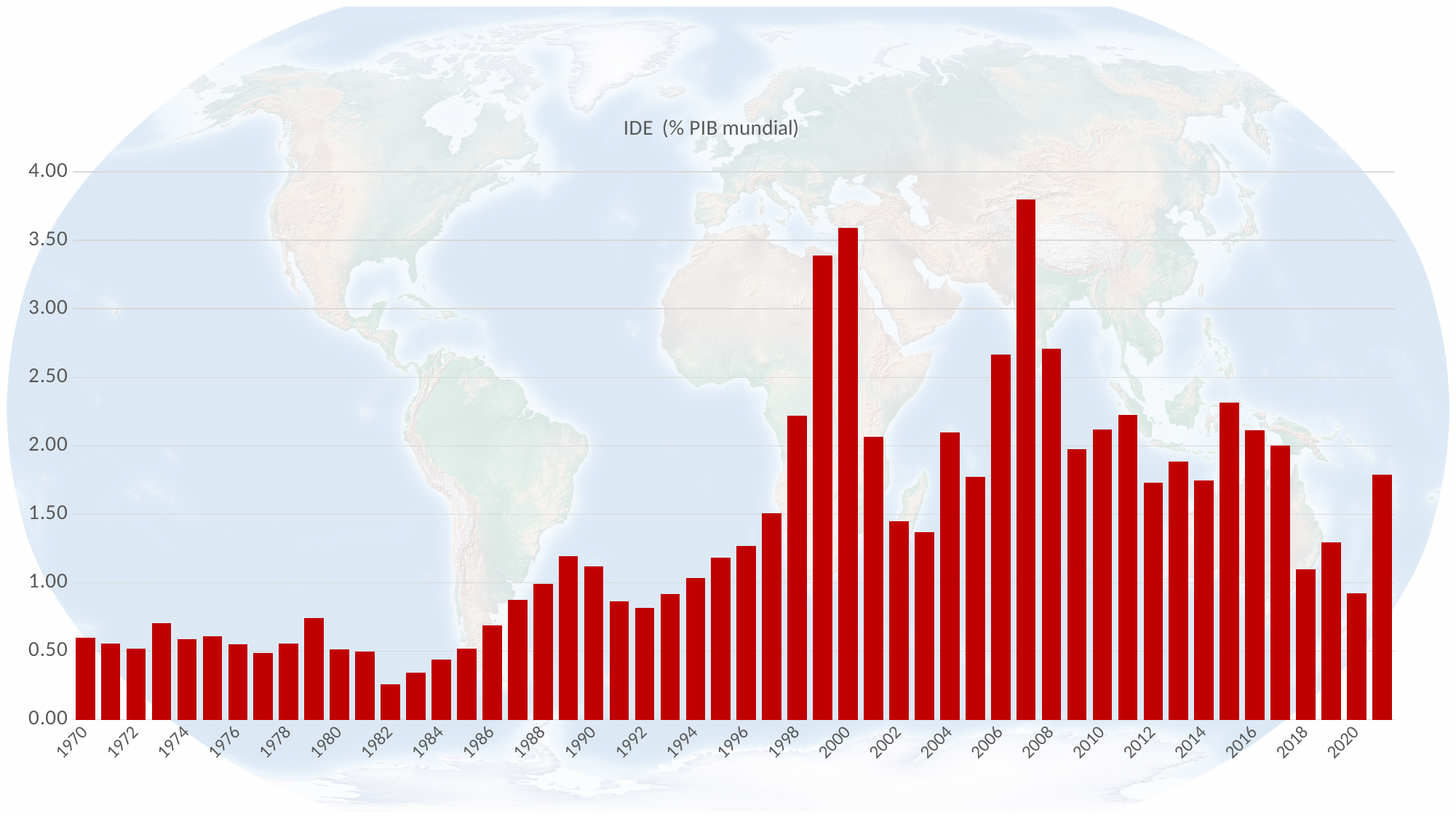
Is the value for 2003 greater or less than 1.50? less Which year has the larger value, 1978 or 1979? 1979 Is the value for 1982 greater or less than 0.50? less Is the value for 2015 greater or less than 2.00? greater Which year has the larger value, 2000 or 2007? 2007 Do the values rise or fall from 1982 to 1990? rise What is the title of the chart? IDE (% PIB mundial) What kind of chart is shown on the slide? Bar chart Which year has the lowest value in the chart? 1982 Which year has the highest value in the chart? 2007